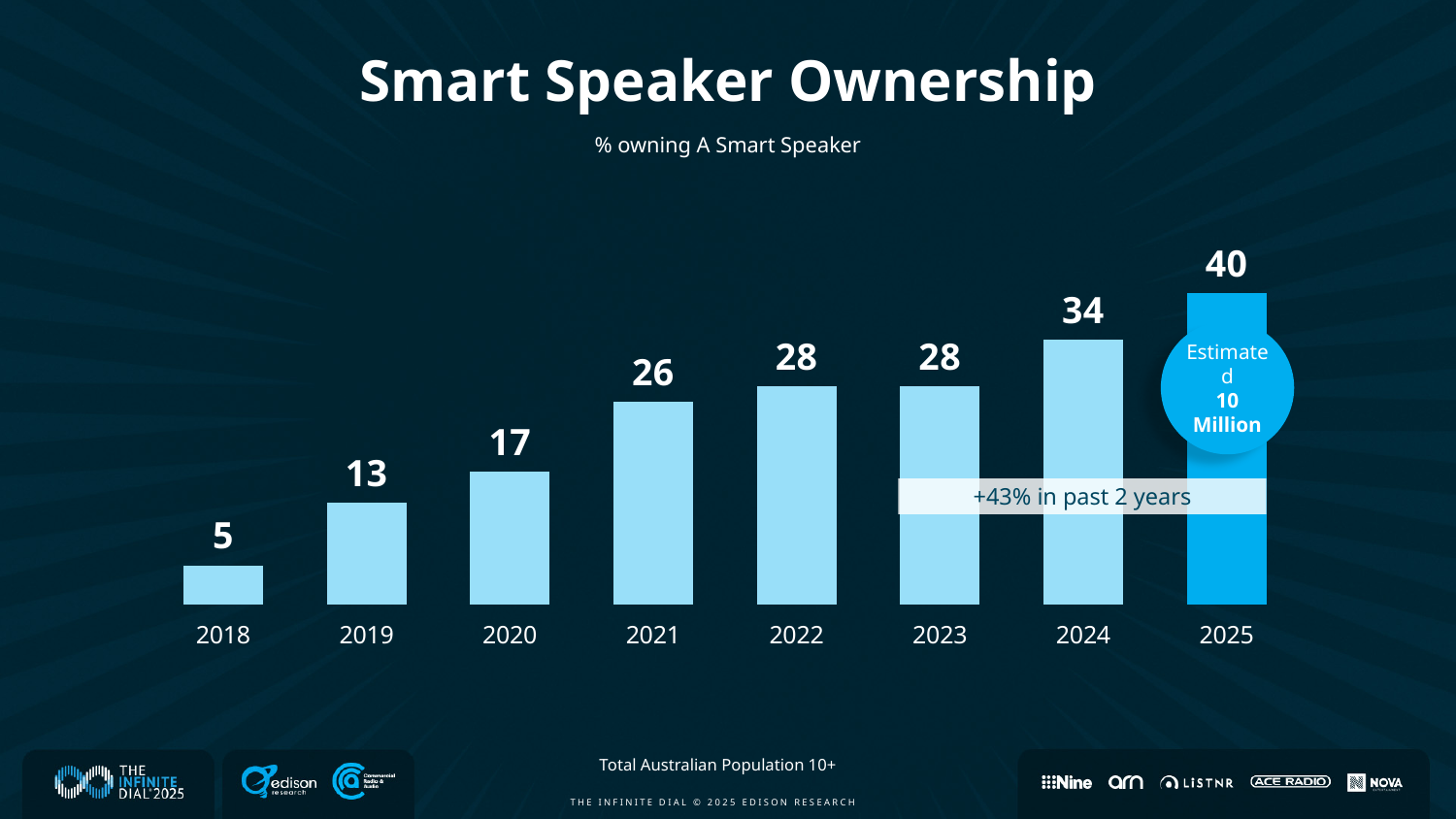
What is the value for 2021? 26 What is the difference between the values for 2020 and 2019? 4 What is the title of the chart? Smart Speaker Ownership Which is larger, the value for 2023 or the value for 2024? 2024 Which year has the highest value? 2025 What is the value for 2018? 5 Do the values generally rise or fall from 2018 to 2025? rise Which year has the lowest value? 2018 What is the difference between the values for 2025 and 2024? 6 How many years are shown on the x axis? 8 What is the value for 2025? 40 What kind of chart is this? bar chart